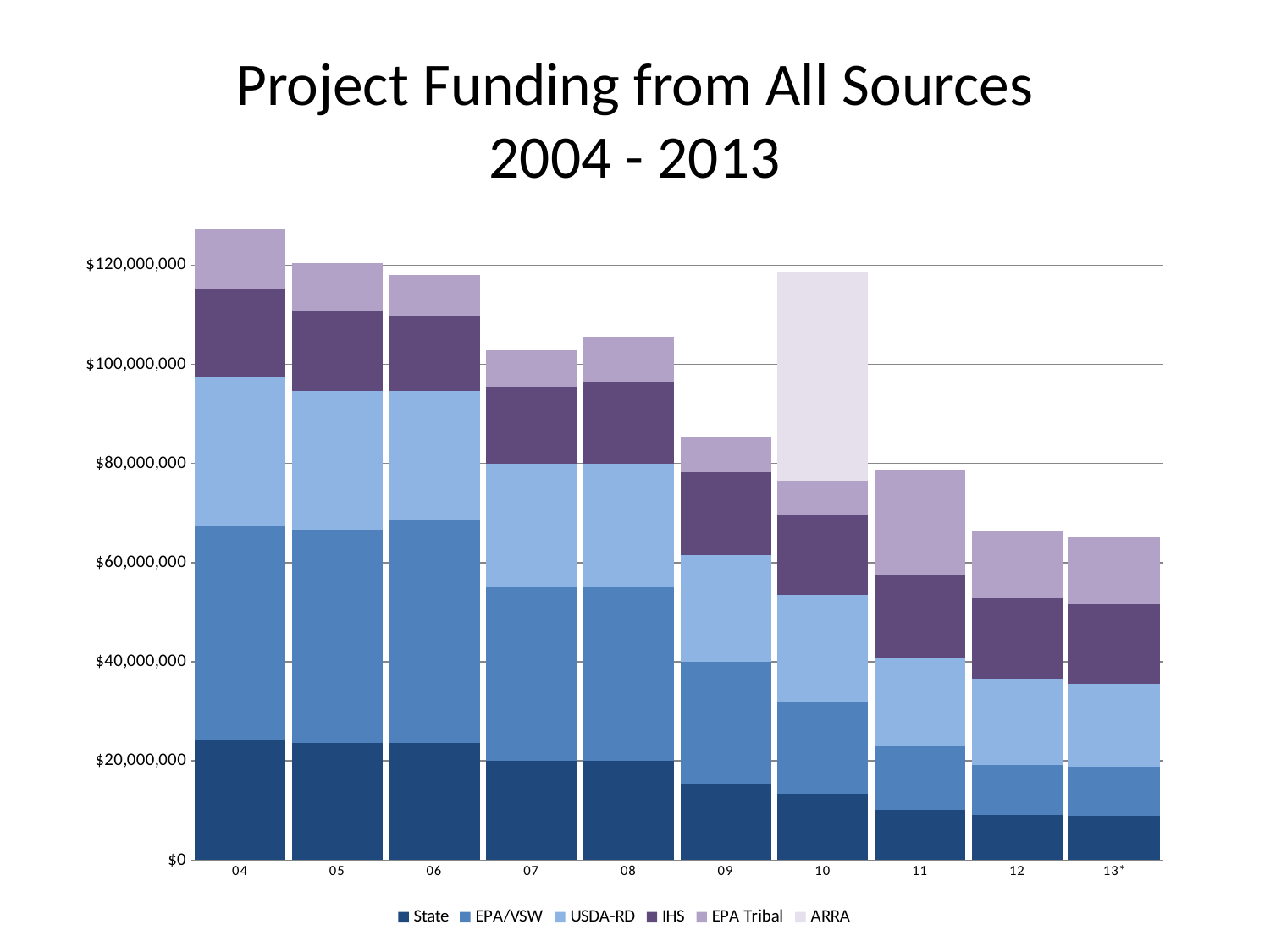
Is the State funding for 13* greater or less than $20,000,000? less Is the total funding for 09 greater or less than $100,000,000? less How many series does the legend list? 6 Which year has larger State funding, 04 or 10? 04 Which year has the highest total project funding? 04 How many years (bars) are shown on the x axis? 10 Overall, does total project funding rise or fall from 04 to 13*? fall In which year does the ARRA series appear? 10 Is the total funding for 12 greater or less than $60,000,000? greater What kind of chart is shown on the slide? Stacked bar chart Which year has larger total funding, 09 or 10? 10